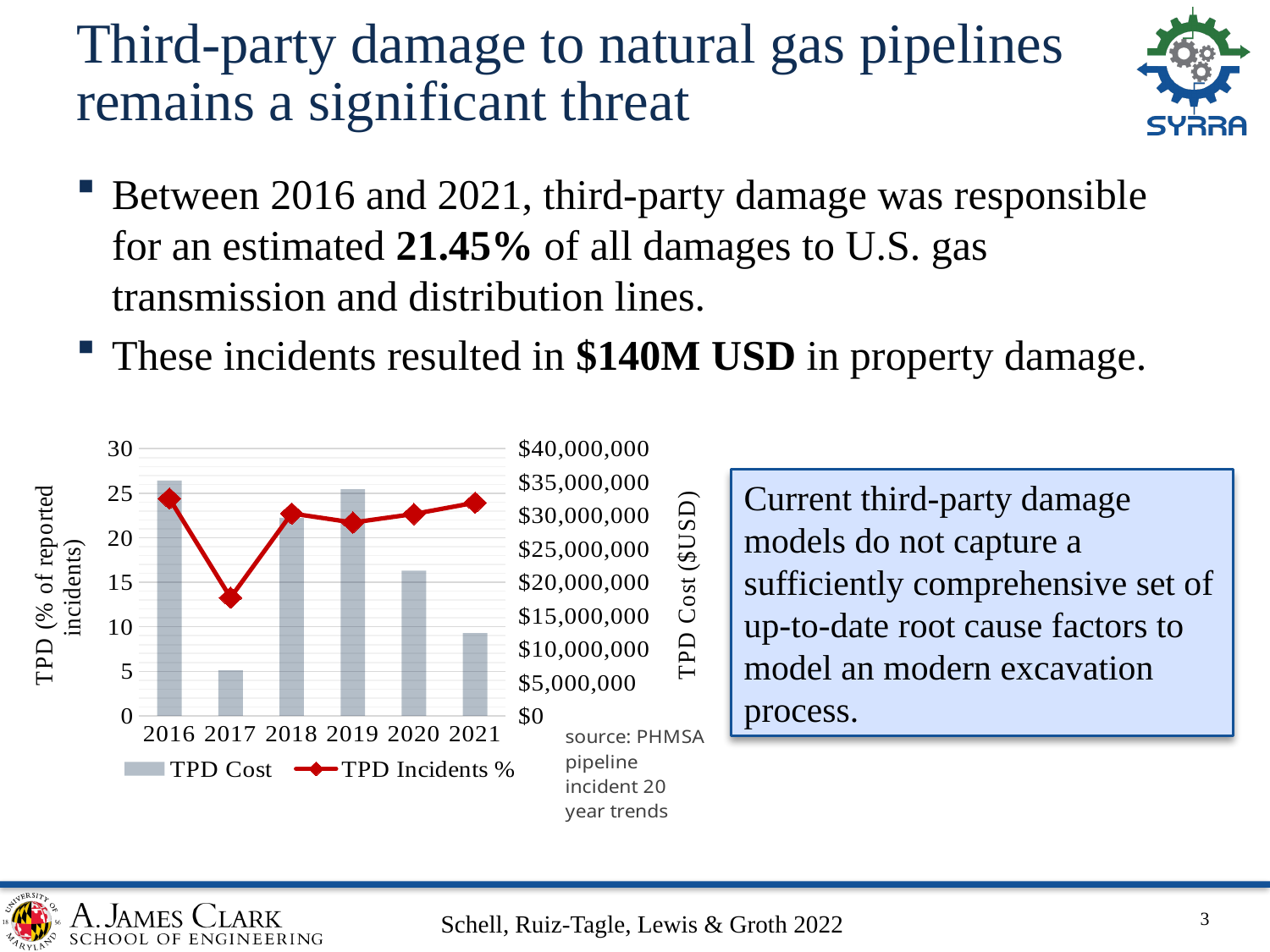
Is the TPD Incidents % for 2017 greater or less than 15? less Is the TPD Cost for 2016 greater or less than $30,000,000? greater What are the two entries in the chart legend? TPD Cost and TPD Incidents % Is the TPD Cost for 2017 greater or less than $10,000,000? less Does the TPD Cost rise or fall from 2019 to 2021? fall How many series does the chart legend list? 2 What kind of chart is shown on the slide? Combined bar and line chart Which year has the lowest TPD Incidents % value? 2017 Which year has the lowest TPD Cost bar? 2017 How many years are shown on the x axis of the chart? 6 Which year has the larger TPD Cost, 2020 or 2021? 2020